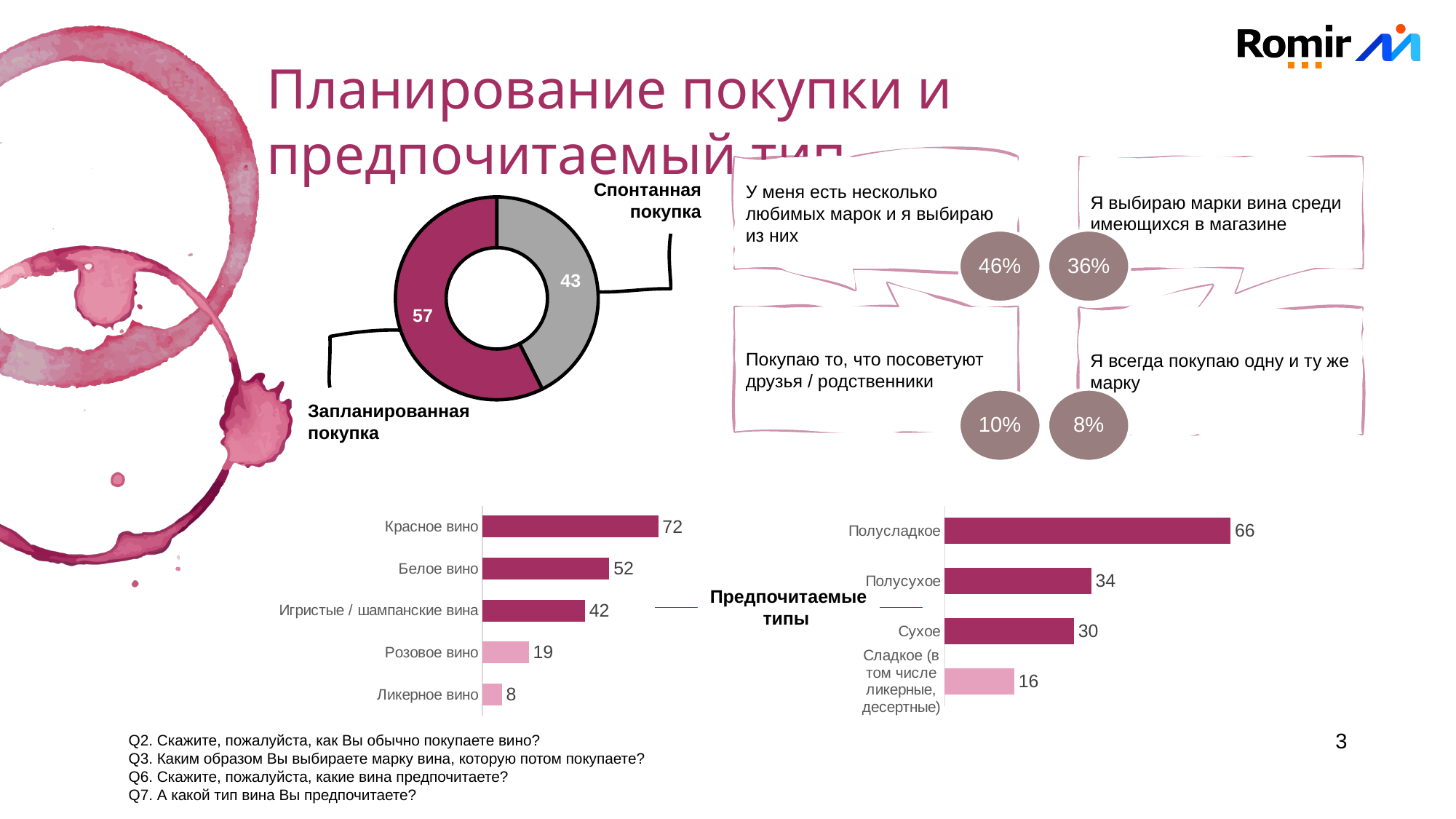
In the donut chart at the top left, what is the value for Спонтанная покупка? 43 In the bar chart at the bottom right, what is the difference between Полусладкое and Полусухое? 32 In the donut chart at the top left, what is the difference between Запланированная покупка and Спонтанная покупка? 14 In the bar chart at the bottom left, which category has the lowest value? Ликерное вино In the bar chart at the bottom right, which category has the highest value? Полусладкое In the donut chart at the top left, what is the value for Запланированная покупка? 57 In the bar chart at the bottom right, what is the value for Сухое? 30 In the bar chart at the bottom left, how many categories are shown? 5 In the donut chart at the top left, which segment is larger: Запланированная покупка or Спонтанная покупка? Запланированная покупка In the bar chart at the bottom left, what is the difference between Белое вино and Игристые / шампанские вина? 10 What kind of chart is shown at the bottom right of the slide? Bar chart In the bar chart at the bottom left, what is the value for Красное вино? 72